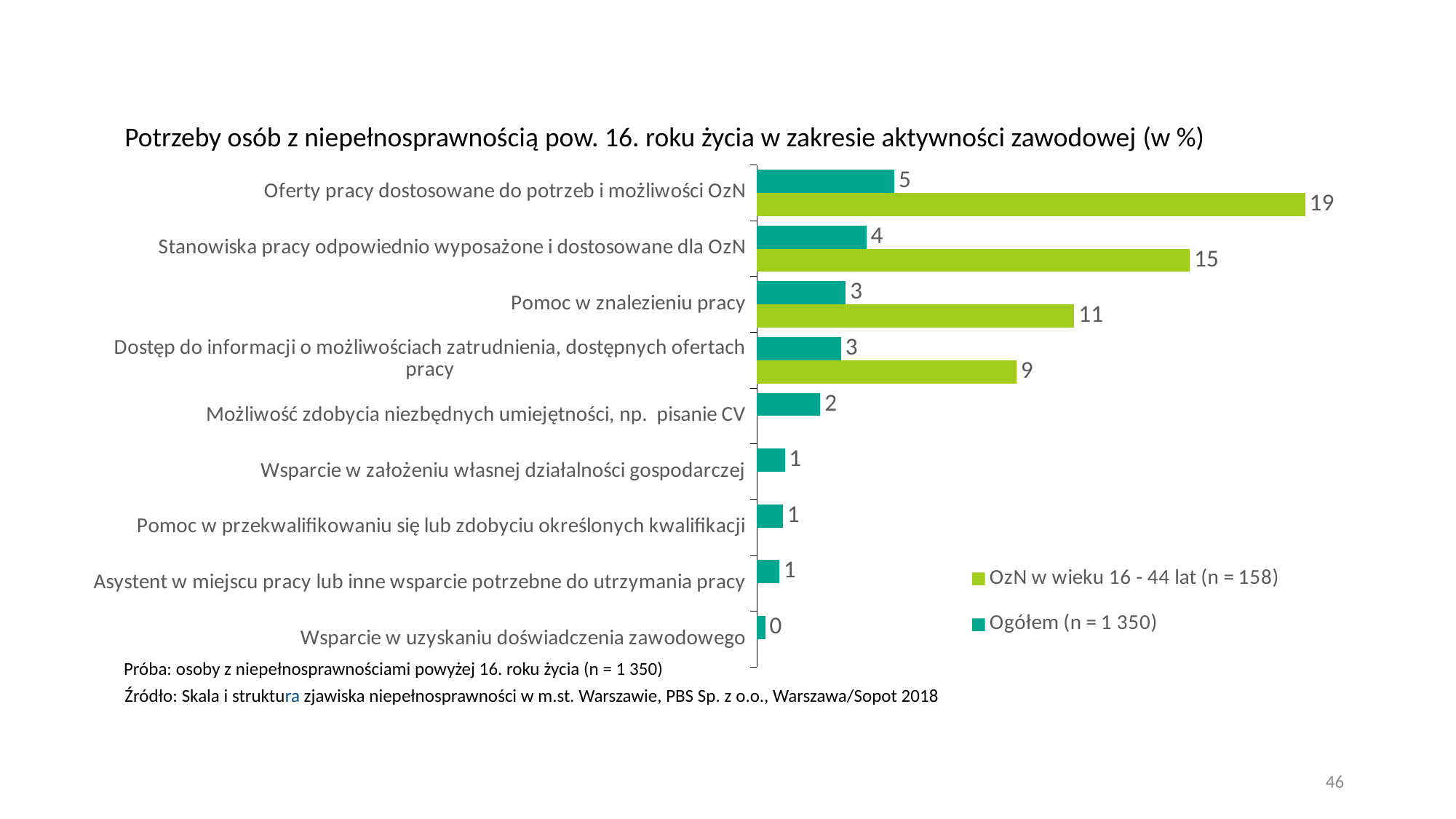
What is the value for "Ogółem (n = 1 350)" for "Wsparcie w uzyskaniu doświadczenia zawodowego"? 0 What is the difference between the "OzN w wieku 16 - 44 lat (n = 158)" and "Ogółem (n = 1 350)" values for "Oferty pracy dostosowane do potrzeb i możliwości OzN"? 14 What is the difference between the "OzN w wieku 16 - 44 lat (n = 158)" values for "Stanowiska pracy odpowiednio wyposażone i dostosowane dla OzN" and "Pomoc w znalezieniu pracy"? 4 Which category has the lowest value for "Ogółem (n = 1 350)"? Wsparcie w uzyskaniu doświadczenia zawodowego For "Dostęp do informacji o możliwościach zatrudnienia, dostępnych ofertach pracy", which series has the larger value: "OzN w wieku 16 - 44 lat (n = 158)" or "Ogółem (n = 1 350)"? OzN w wieku 16 - 44 lat (n = 158) What is the value for "Ogółem (n = 1 350)" for "Oferty pracy dostosowane do potrzeb i możliwości OzN"? 5 How many series does the legend list? 2 How many categories are shown on the chart? 9 What is the value for "OzN w wieku 16 - 44 lat (n = 158)" for "Pomoc w znalezieniu pracy"? 11 What is the value for "OzN w wieku 16 - 44 lat (n = 158)" for "Stanowiska pracy odpowiednio wyposażone i dostosowane dla OzN"? 15 What kind of chart is shown on the slide? Bar chart Which category has the highest value for "OzN w wieku 16 - 44 lat (n = 158)"? Oferty pracy dostosowane do potrzeb i możliwości OzN